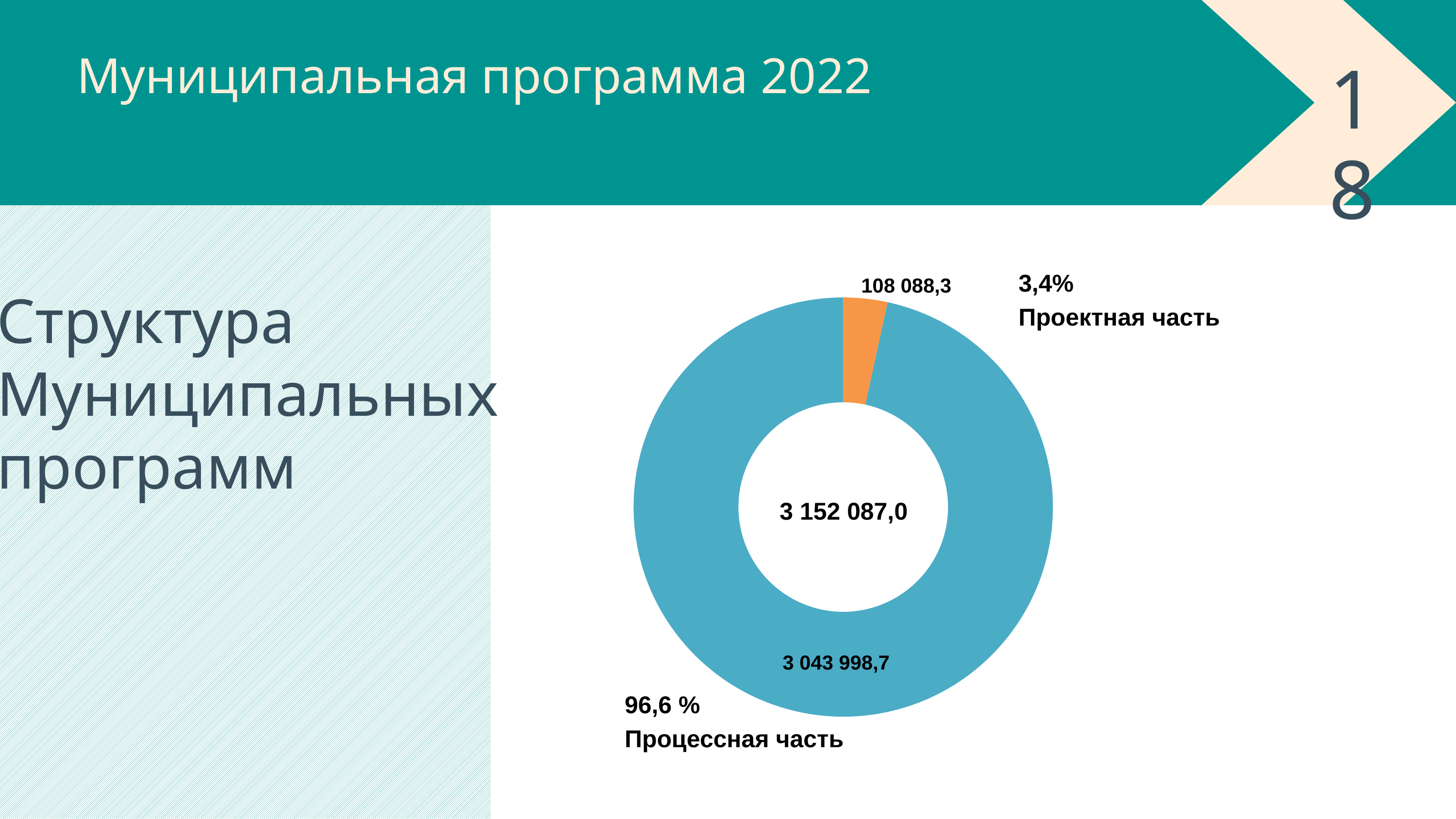
How many categories are shown in the chart? 2 What kind of chart is shown on the slide? Donut (pie) chart What is the total shown in the centre of the donut chart? 3 152 087,0 What colour is the slice for Проектная часть? Orange What is the difference between the values for Процессная часть and Проектная часть? 2 935 910,4 Which is larger, Проектная часть or Процессная часть? Процессная часть What is the value for Проектная часть? 108 088,3 What is the value for Процессная часть? 3 043 998,7 Which category has the largest slice? Процессная часть Which category has the smallest slice? Проектная часть What share of the chart does Процессная часть represent? 96,6 % What share of the chart does Проектная часть represent? 3,4%